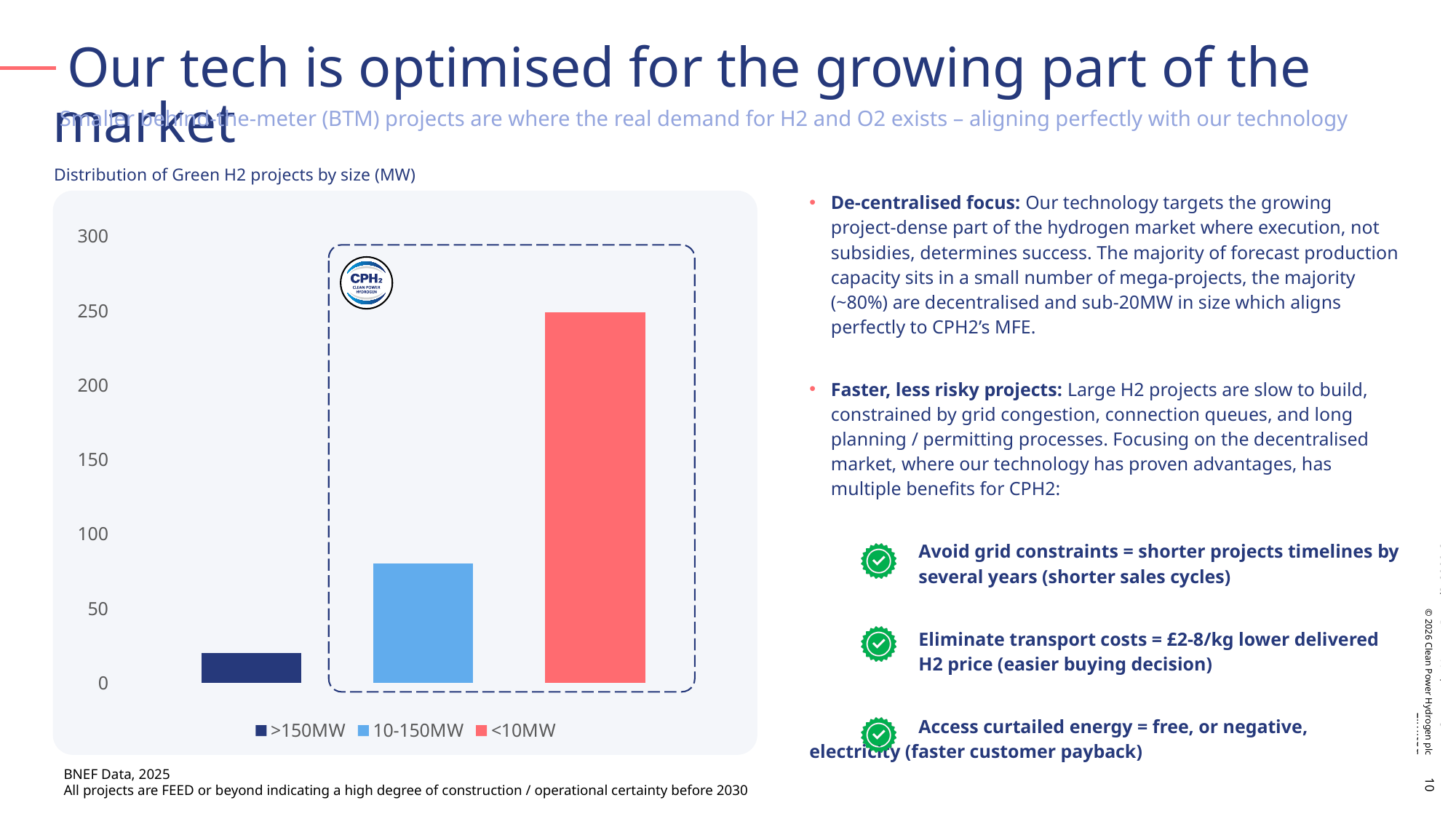
How many entries does the chart legend list? 3 Is the value for >150MW greater or less than 50? less Which project size category has the lowest value? >150MW Do the bar values rise or fall from left to right across the chart? Rise Which is larger, the value for 10-150MW or the value for >150MW? 10-150MW Is the value for <10MW greater or less than 200? greater What is the title of the chart? Distribution of Green H2 projects by size (MW) Is the value for 10-150MW greater or less than 100? less What kind of chart is shown on the slide? Bar chart What colour is the bar for the <10MW category? Red Which project size category has the highest value? <10MW How many bars are plotted in the chart? 3